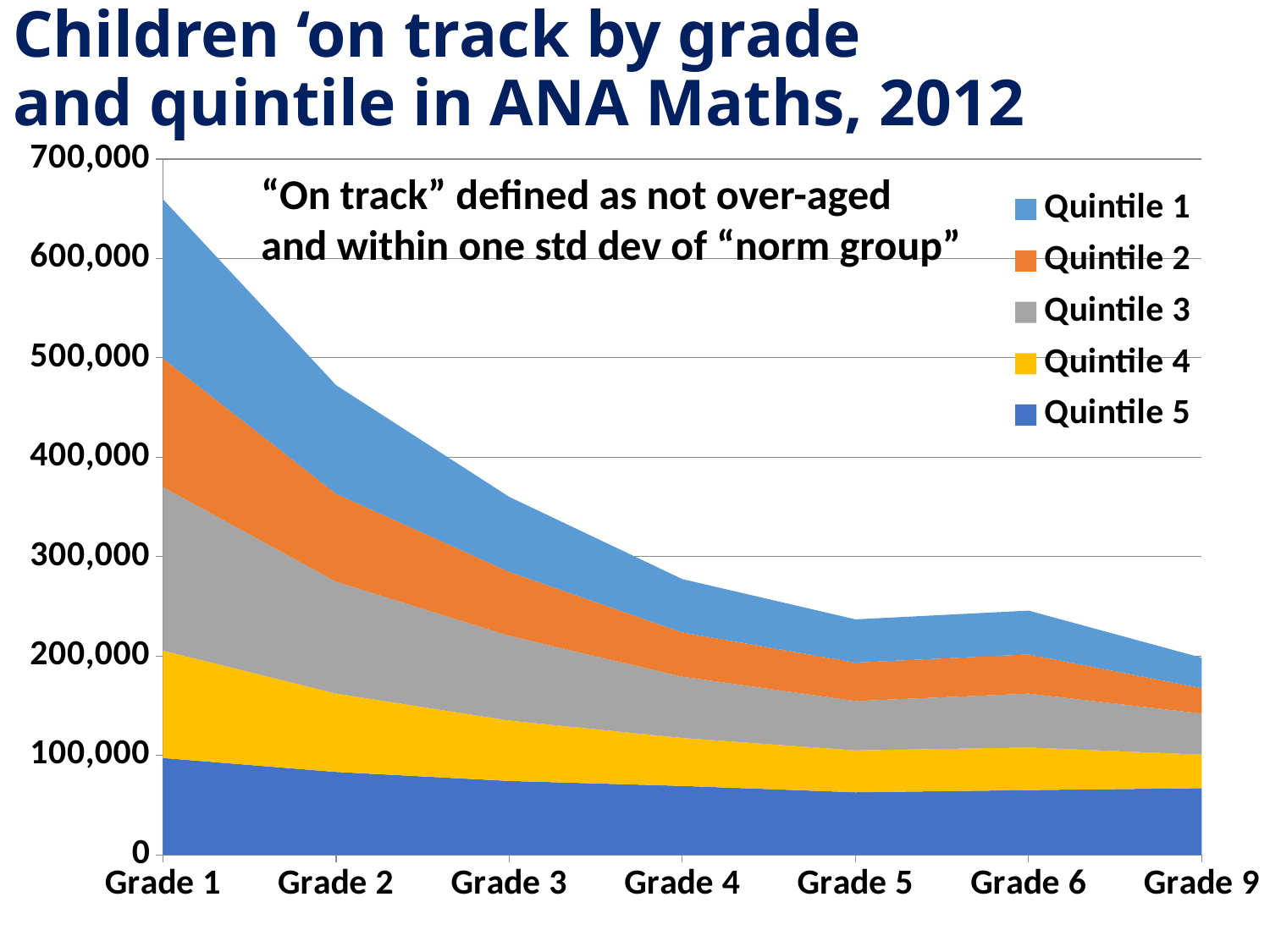
Which series is shown at the bottom of the stacked areas? Quintile 5 Which grade has the lowest total number of children on track? Grade 9 Which grade has the highest total number of children on track? Grade 1 What kind of chart is shown on the slide? Stacked area chart How many grades are shown along the x axis? 7 How many series does the legend list? 5 Is the total number of children on track in Grade 2 greater or less than 500,000? less Is the total number of children on track in Grade 4 greater or less than 300,000? less Is the total for Grade 1 larger or smaller than the total for Grade 3? larger Is the total number of children on track in Grade 1 greater or less than 600,000? greater Does the total number of children on track generally rise or fall from Grade 1 to Grade 9? fall